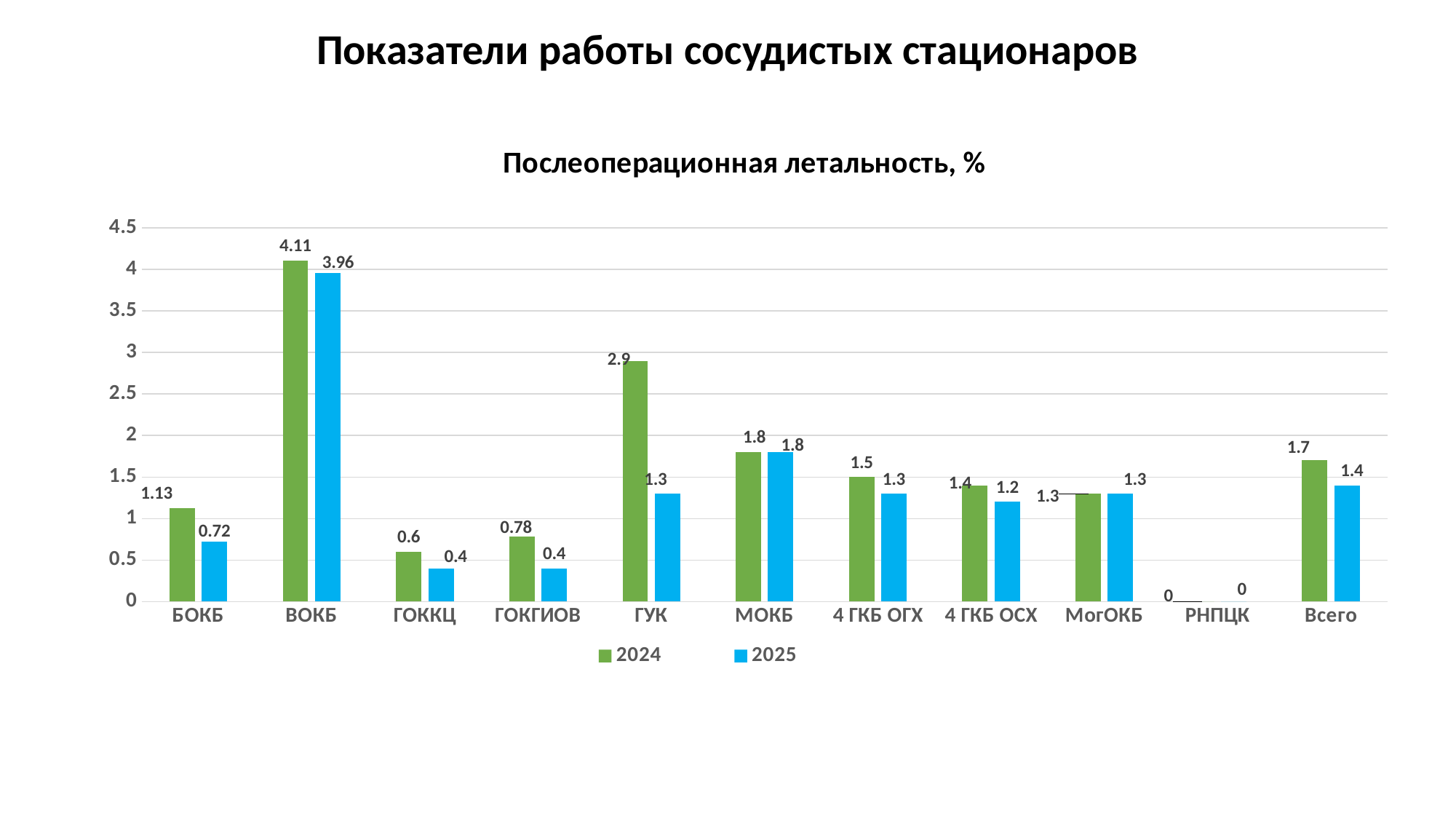
What is the 2025 value for БОКБ? 0.72 How many series does the legend list? 2 Which category has the highest 2024 value? ВОКБ What is the title of the chart? Послеоперационная летальность, % What is the 2024 value for ВОКБ? 4.11 What is the 2025 value for ГУК? 1.3 How many categories are shown on the x axis? 11 What kind of chart is shown on the slide? Bar chart Which category has the lowest 2025 value? РНПЦК What is the 2024 value for Всего? 1.7 What is the difference between the 2024 and 2025 values for ГУК? 1.6 Which is larger for ГОКГИОВ: the 2024 value or the 2025 value? 2024